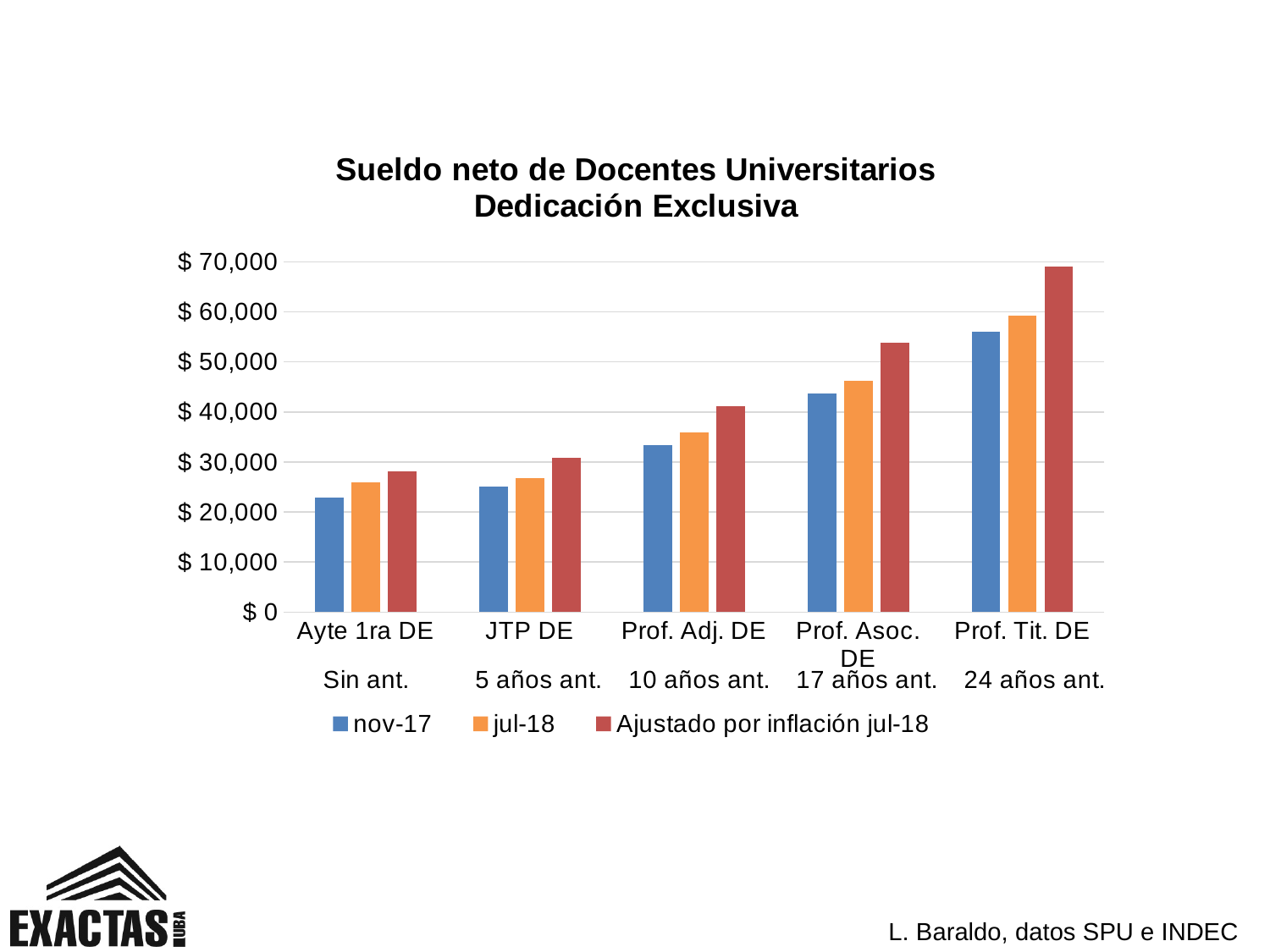
How many categories (teaching positions) are shown on the x axis? 5 Which is larger: the 'Ajustado por inflación jul-18' value for Ayte 1ra DE or the 'nov-17' value for JTP DE? Ajustado por inflación jul-18 for Ayte 1ra DE Which category has the lowest value for the 'nov-17' series? Ayte 1ra DE What kind of chart is shown on the slide? bar chart Is the 'nov-17' value for Ayte 1ra DE greater or less than $ 30,000? less Do the 'jul-18' values rise or fall moving from Ayte 1ra DE to Prof. Tit. DE along the x axis? rise How many series does the legend list? 3 Is the 'Ajustado por inflación jul-18' value for Prof. Tit. DE greater or less than $ 60,000? greater What is the title of the chart? Sueldo neto de Docentes Universitarios Dedicación Exclusiva Is the 'nov-17' value for Prof. Asoc. DE greater or less than $ 40,000? greater Which category has the highest value for the 'Ajustado por inflación jul-18' series? Prof. Tit. DE